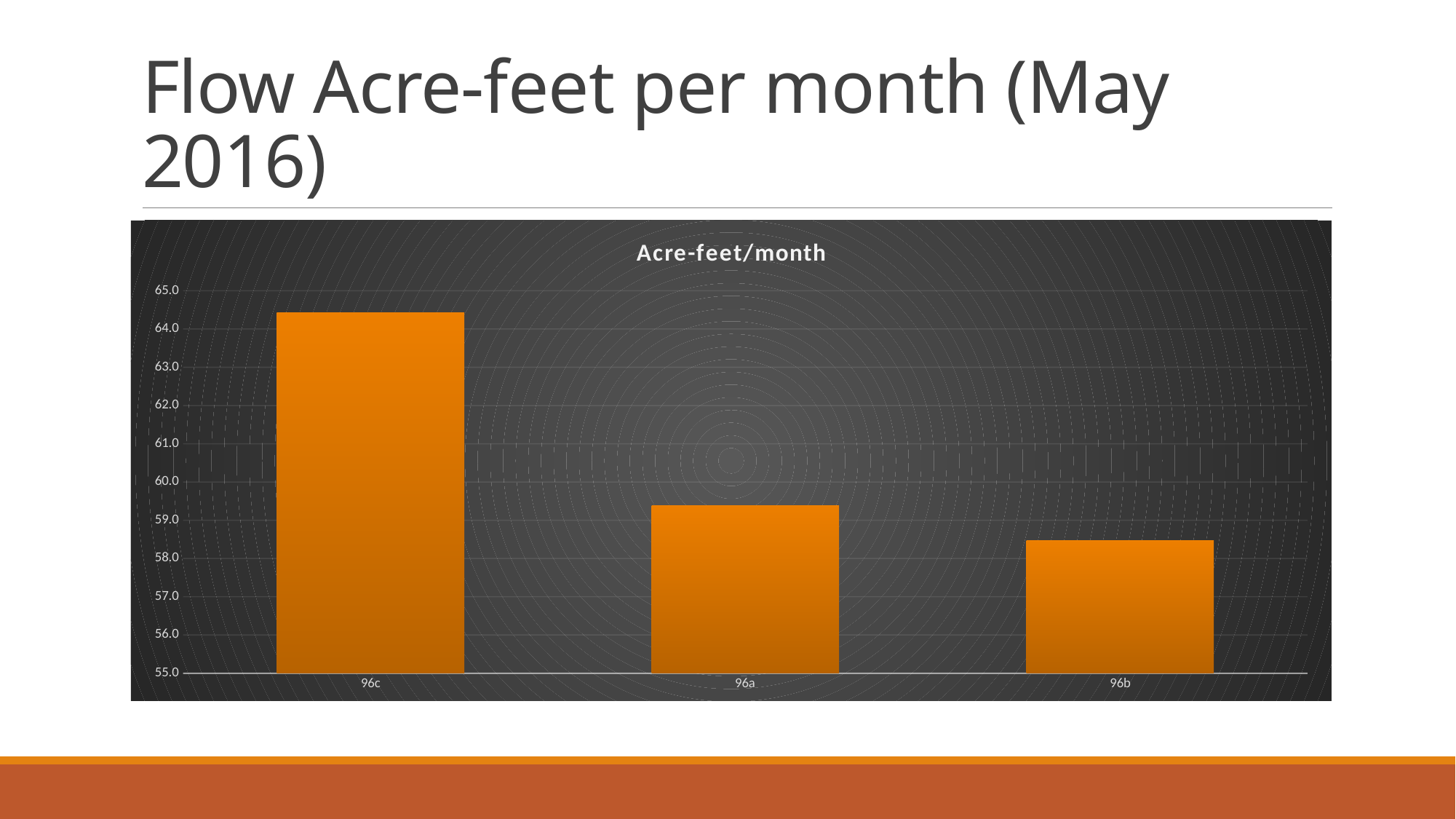
Is the value for 96a greater or less than 60.0? less Which category has the lowest value in the chart? 96b What is the title of the chart? Acre-feet/month How many categories are shown on the x axis of the chart? 3 What colour are the bars in the chart? orange Which has a larger value, 96c or 96a? 96c Do the bar values rise or fall from left to right along the x axis? fall What kind of chart is shown on the slide? bar chart Which has a larger value, 96a or 96b? 96a Is the value for 96c greater or less than 64.0? greater Which category has the highest value in the chart? 96c Is the value for 96b greater or less than 58.0? greater